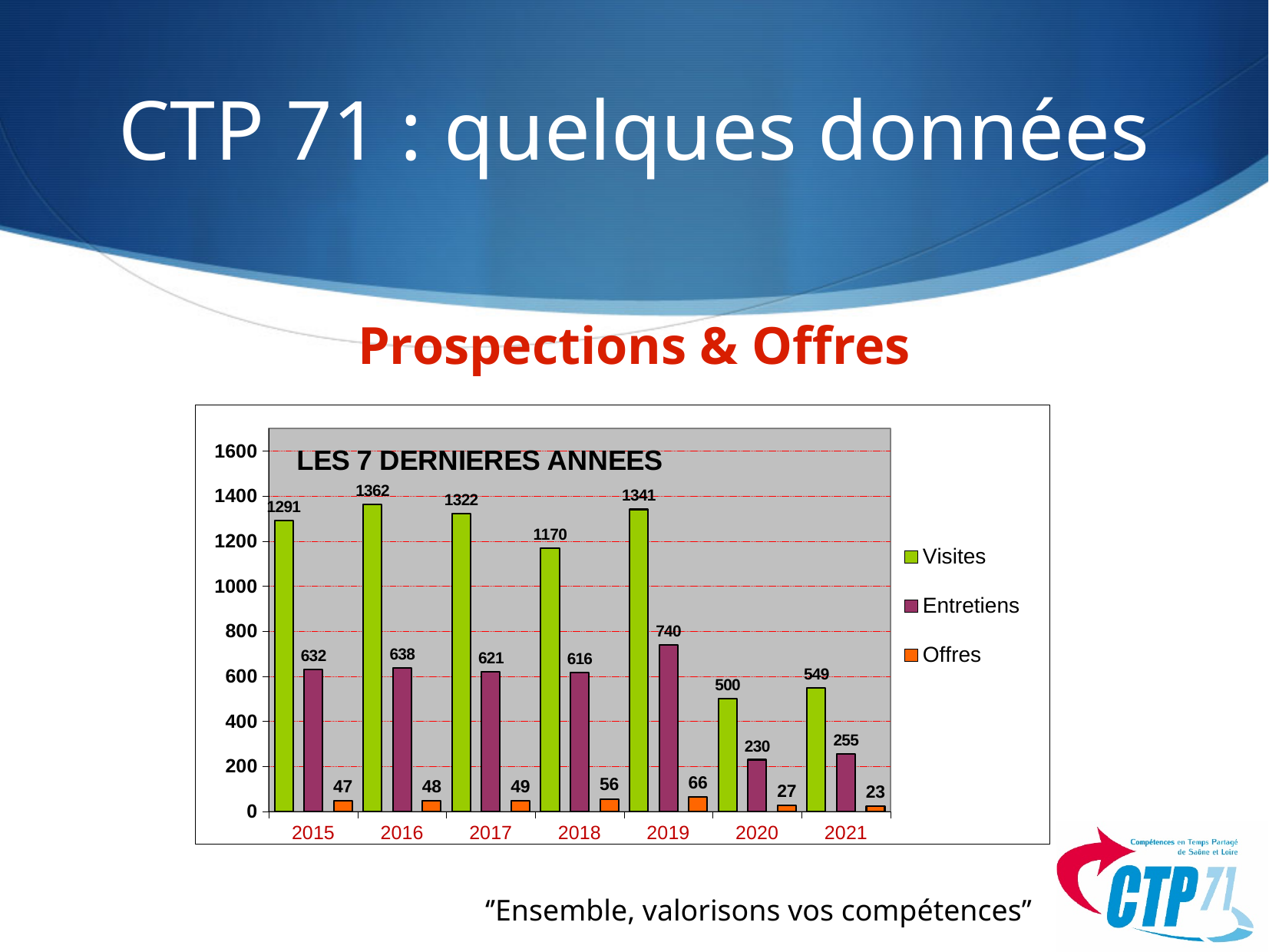
Do the Visites values rise or fall from 2019 to 2020? Fall Which is larger, Entretiens in 2015 or Entretiens in 2016? Entretiens in 2016 How many series does the legend list? 3 How many years are shown on the x axis? 7 What is the title printed inside the chart area? LES 7 DERNIERES ANNEES What is the difference between Visites in 2019 and Visites in 2020? 841 Which year has the highest value for Visites? 2016 What is the value of Entretiens in 2019? 740 What kind of chart is shown? Bar chart What is the value of Offres in 2021? 23 Which year has the lowest value for Offres? 2021 What is the value of Visites in 2016? 1362